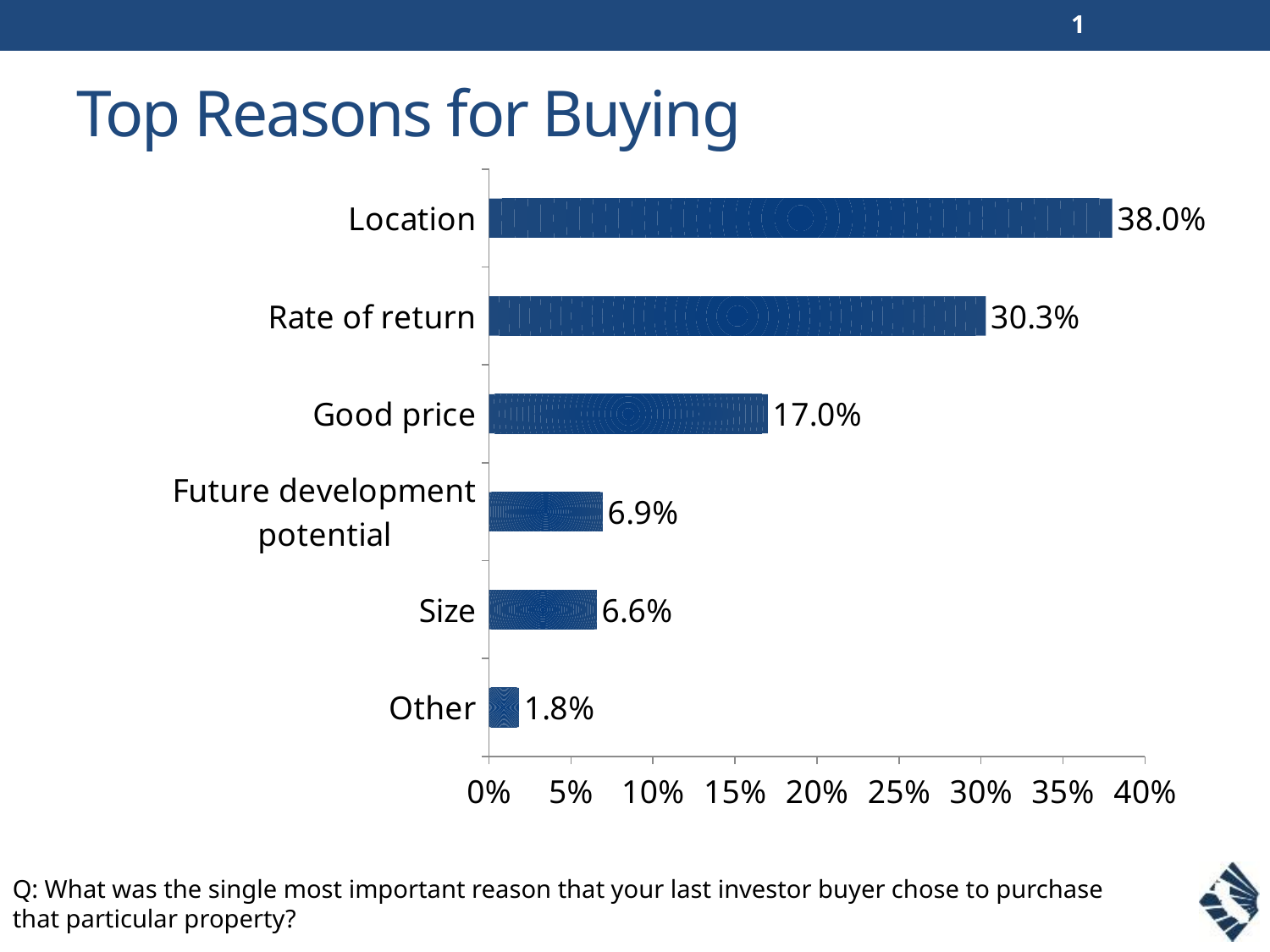
Which category has the highest value? Location What is the difference between the values for Good price and Size? 10.4% How many categories are shown in the chart? 6 What is the value for Rate of return? 30.3% Which category has the lowest value? Other What is the value for Other? 1.8% What kind of chart is shown on the slide? Bar chart What is the value for Future development potential? 6.9% What is the title of the chart? Top Reasons for Buying What is the value for Location? 38.0% What is the difference between the values for Location and Rate of return? 7.7% Which is larger, the value for Good price or the value for Size? Good price